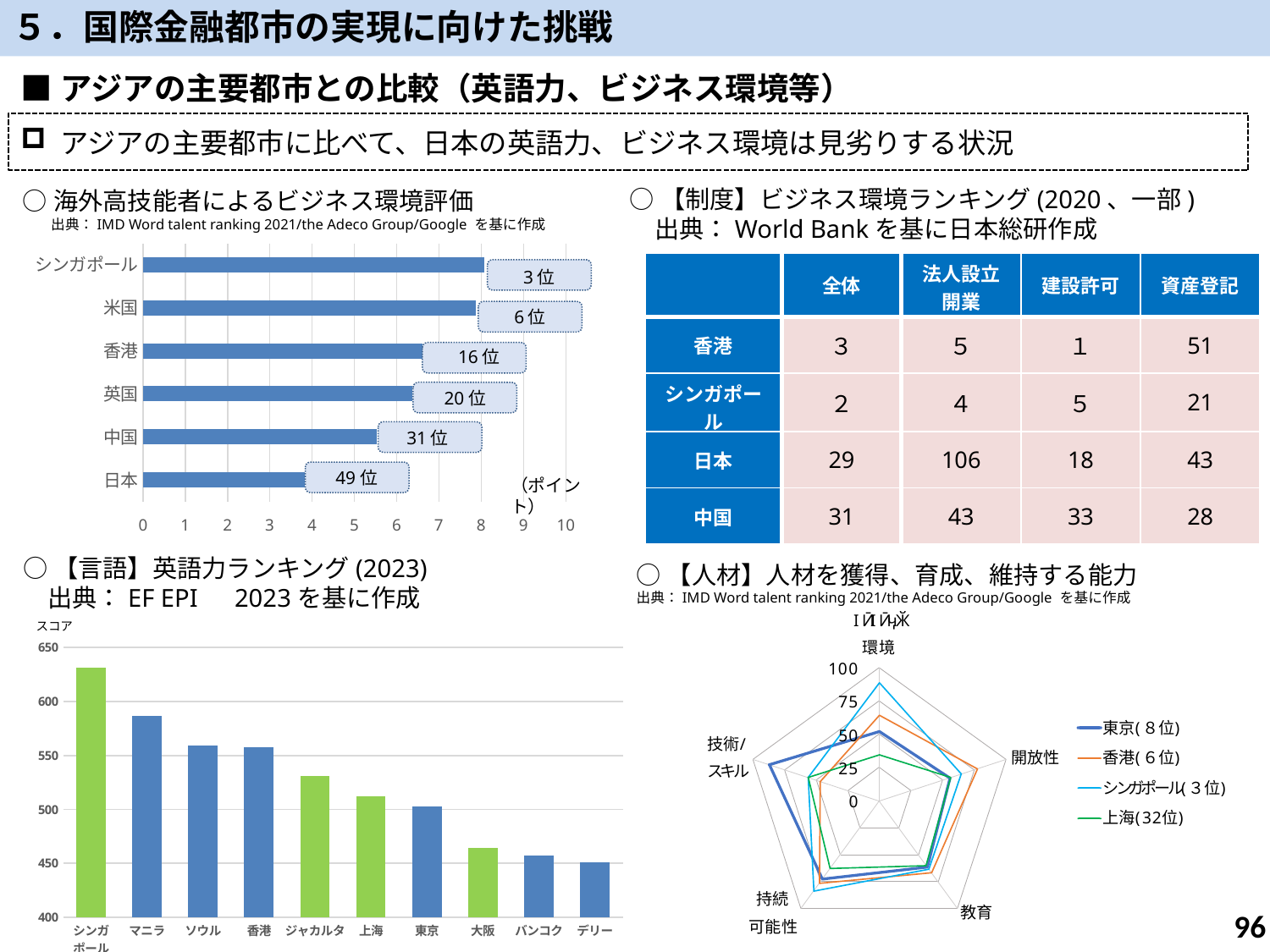
In the bottom-left chart (英語力ランキング 2023), is the value for シンガポール greater or less than 600? greater In the top-left horizontal bar chart (海外高技能者によるビジネス環境評価), which country has the longest bar? シンガポール In the top-left horizontal bar chart (海外高技能者によるビジネス環境評価), which country has the shortest bar? 日本 In the top-left horizontal bar chart (海外高技能者によるビジネス環境評価), what rank label is shown for 日本? 49位 In the bottom-left chart (英語力ランキング 2023), how many cities are plotted? 10 In the top-left horizontal bar chart (海外高技能者によるビジネス環境評価), how many countries are plotted? 6 In the bottom-right radar chart (人材を獲得、育成、維持する能力), how many series does the legend list? 4 In the bottom-left chart (英語力ランキング 2023), which city has the highest score? シンガポール In the bottom-left chart (英語力ランキング 2023), is the value for 大阪 greater or less than 500? less In the bottom-left chart (英語力ランキング 2023), do the scores rise or fall from left to right? fall In the top-left horizontal bar chart (海外高技能者によるビジネス環境評価), is the value for 日本 greater or less than 4? less In the top-left horizontal bar chart (海外高技能者によるビジネス環境評価), what rank label is shown for シンガポール? 3位